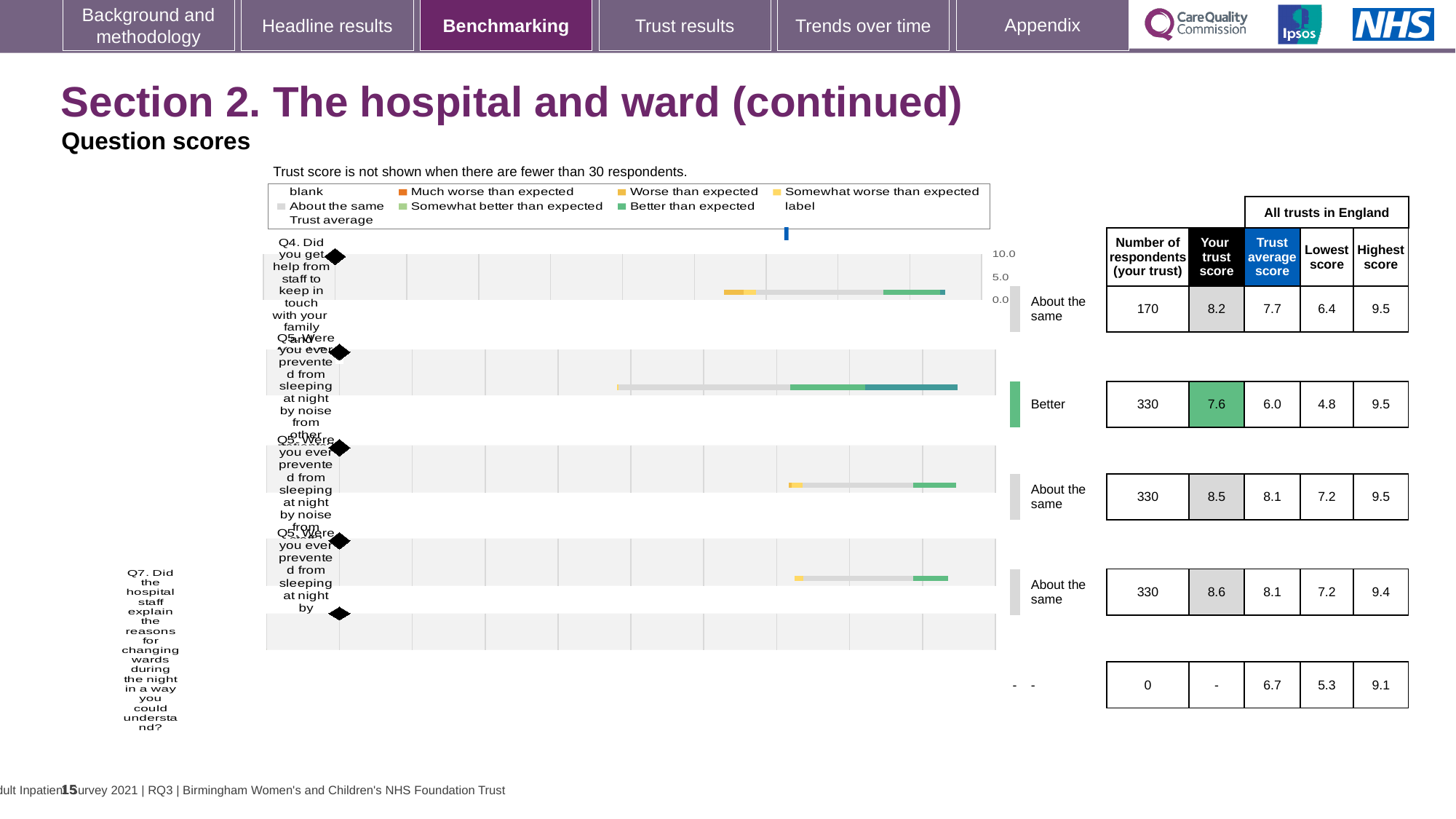
What is the trust average score for Q4? 7.7 What benchmark category is shown for the second question row from the top? Better How many respondents (your trust) are shown for Q4? 170 What is the difference between the highest score and the lowest score for Q4? 3.1 What is the 'Your trust score' value for Q4 (help from staff to keep in touch with family)? 8.2 What is the highest 'Your trust score' value shown in the table? 8.6 For Q4, which is larger: your trust score or the trust average score? Your trust score (8.2) How many respondents (your trust) are shown for Q7 (explaining reasons for changing wards during the night)? 0 What kind of chart is used to show the question scores on this slide? bar chart What benchmark category is shown for Q4? About the same What is the 'Your trust score' value for the second question row from the top? 7.6 According to the note above the chart, when is the trust score not shown? When there are fewer than 30 respondents